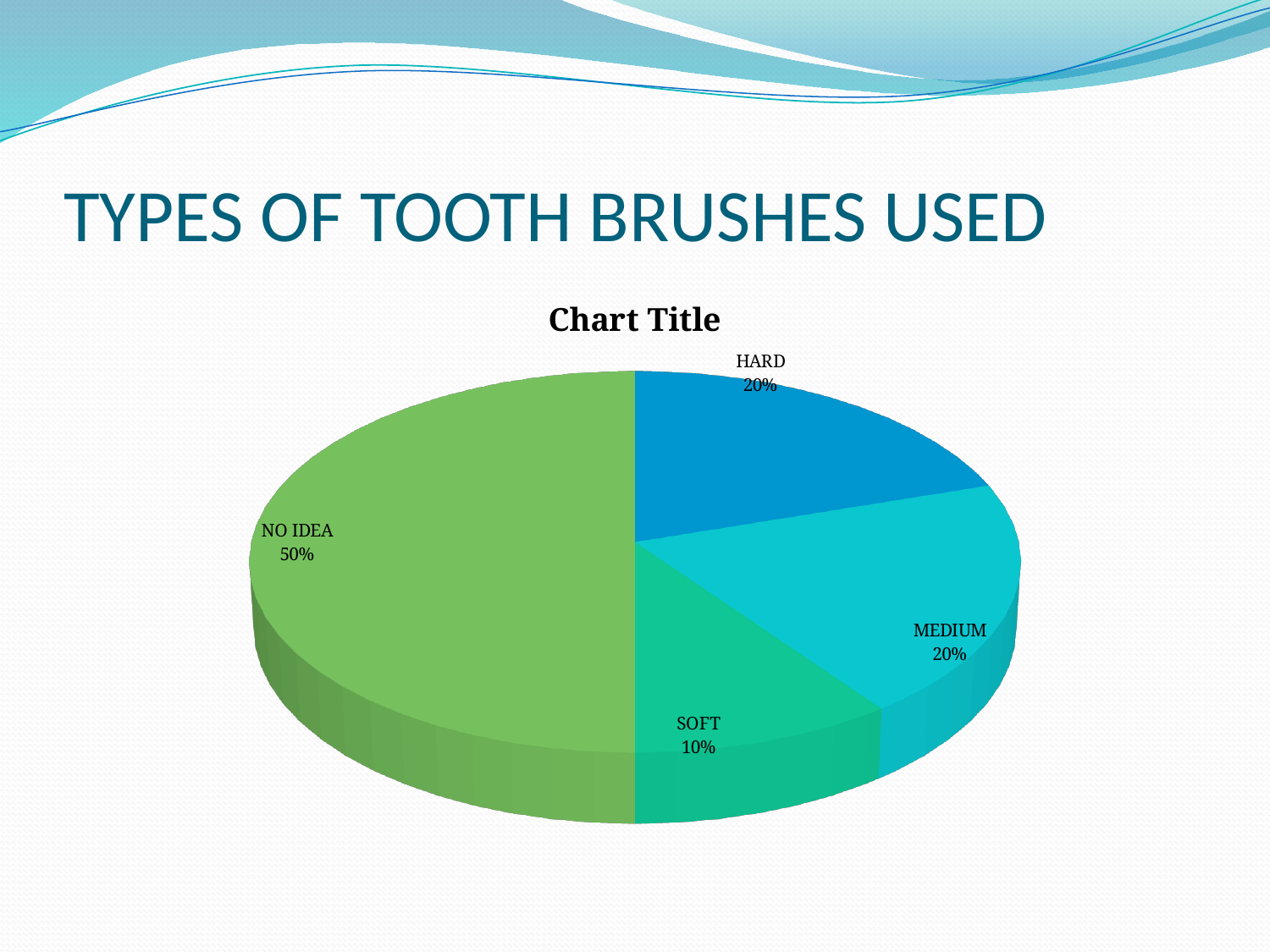
What is the difference in percentage points between NO IDEA and SOFT? 40 What percentage of the pie is labelled SOFT? 10% What is the title printed above the pie chart? Chart Title What percentage of the pie is labelled HARD? 20% How many slices does the pie chart have? 4 Which category has the smallest slice of the pie? SOFT What type of chart is shown on the slide? pie chart Which is larger, the HARD slice or the SOFT slice? HARD What percentage of the pie is labelled MEDIUM? 20% Which category has the largest slice of the pie? NO IDEA What colour is the NO IDEA slice? green What percentage of the pie is labelled NO IDEA? 50%